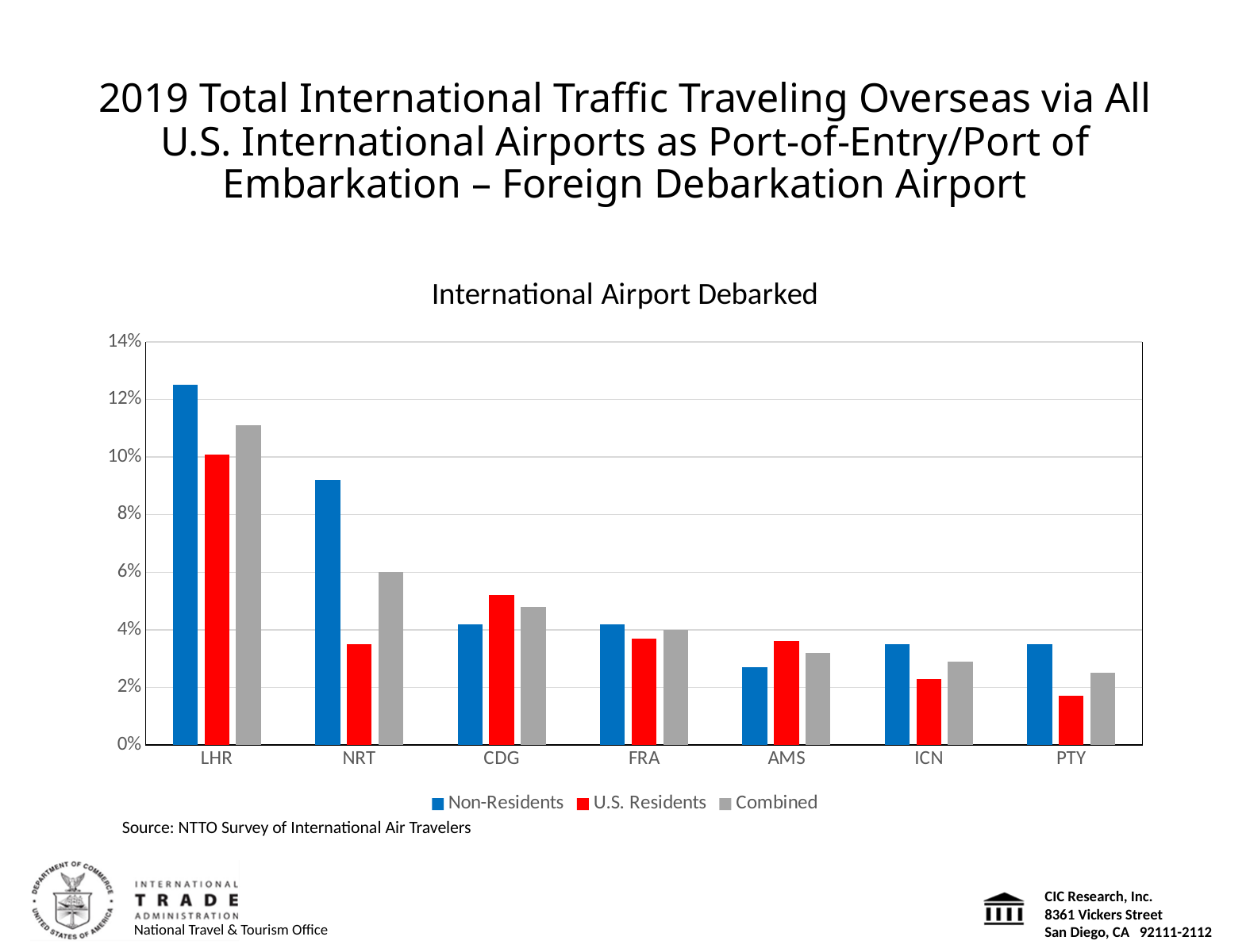
How many airports are shown on the x axis of the chart? 7 What kind of chart is shown on the slide? Bar chart Which airport has the lowest U.S. Residents value? PTY What is the title of the chart? International Airport Debarked How many series does the chart's legend list? 3 Is the Non-Residents value for AMS greater or less than 4%? less For CDG, which is larger: the Non-Residents value or the U.S. Residents value? U.S. Residents Is the U.S. Residents value for NRT greater or less than 4%? less Which airport has the highest Non-Residents value? LHR Which is larger: the Non-Residents value for NRT or the U.S. Residents value for LHR? U.S. Residents value for LHR Do the Combined values rise or fall moving from LHR to PTY along the x axis? Fall Is the Non-Residents value for LHR greater or less than 12%? greater